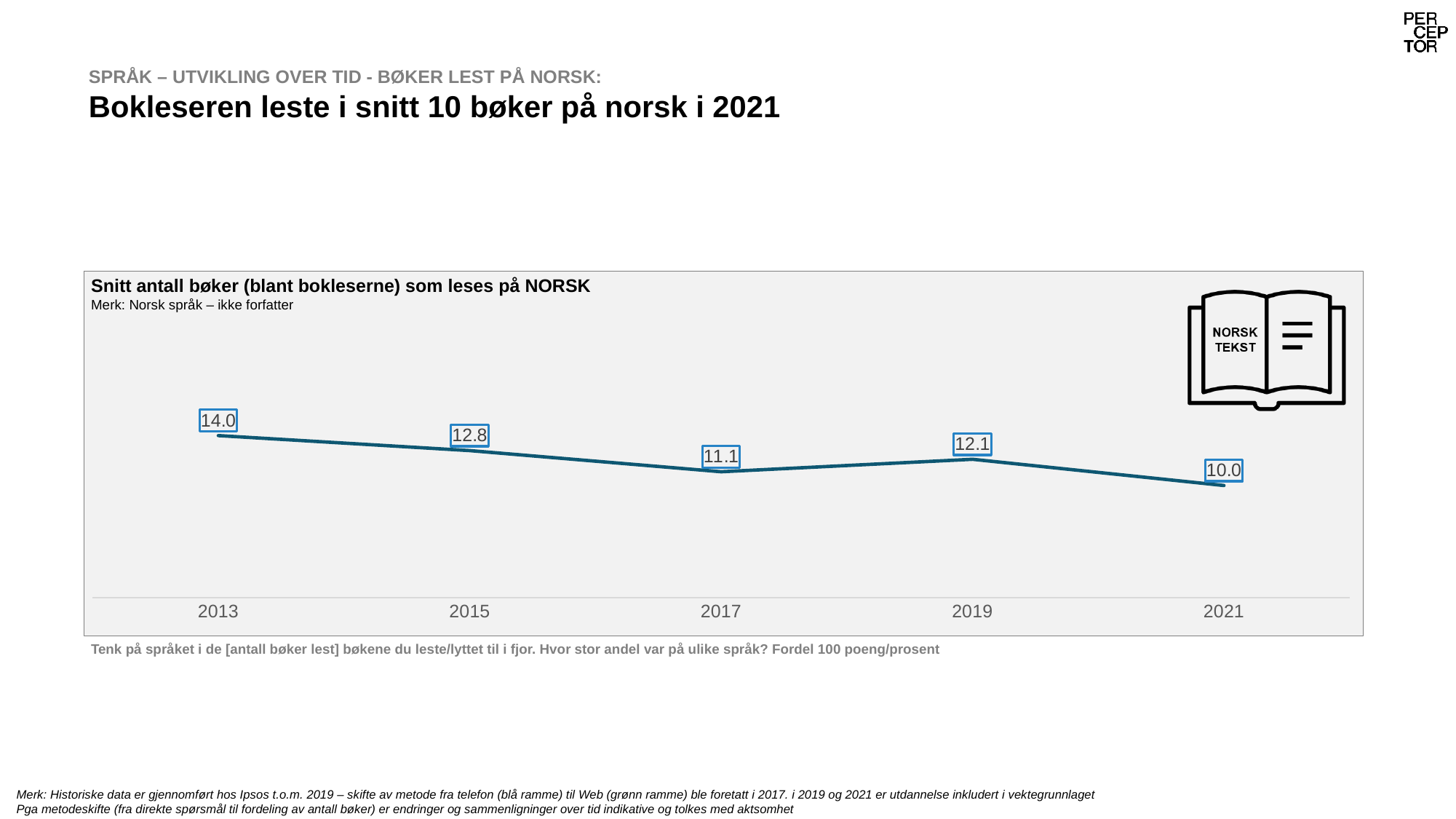
What is the overall trend of the values from 2013 to 2021? falling What is the difference between the values for 2019 and 2017? 1.0 Which is larger, the value for 2015 or the value for 2019? 2015 What is the value shown for 2019? 12.1 How many years are plotted on the chart? 5 What kind of chart is shown? line chart Which year has the highest value? 2013 Which year has the lowest value? 2021 What is the average number of books read in Norwegian in 2013? 14.0 What is the value shown for 2021? 10.0 What is the difference between the values for 2013 and 2021? 4.0 What is the value shown for 2017? 11.1